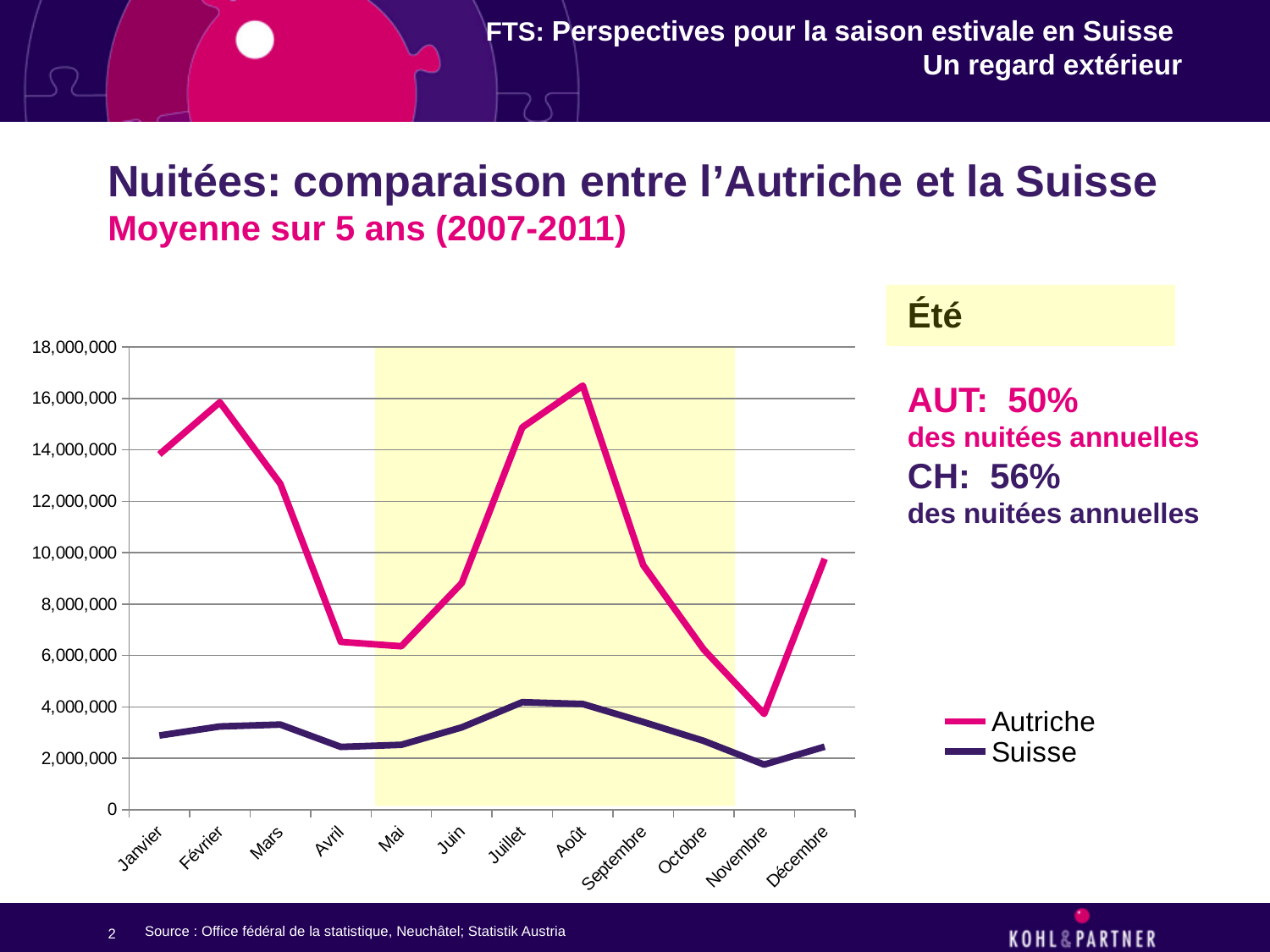
Does the Autriche series rise or fall from Août to Novembre? fall In which month does the Autriche series reach its highest value? Août Is the value for Autriche in Août greater or less than 16,000,000? greater Which series has the higher value in Juillet, Autriche or Suisse? Autriche What kind of chart is shown on the slide? line chart Is the value for Suisse in Janvier greater or less than 2,000,000? greater Is the value for Autriche in Novembre greater or less than 4,000,000? less Which series is drawn in the pink/magenta line according to the legend? Autriche In which month does the Suisse series reach its lowest value? Novembre How many series does the chart legend list? 2 How many months are plotted along the x axis of the chart? 12 Does the Suisse series rise or fall from Avril to Juillet? rise